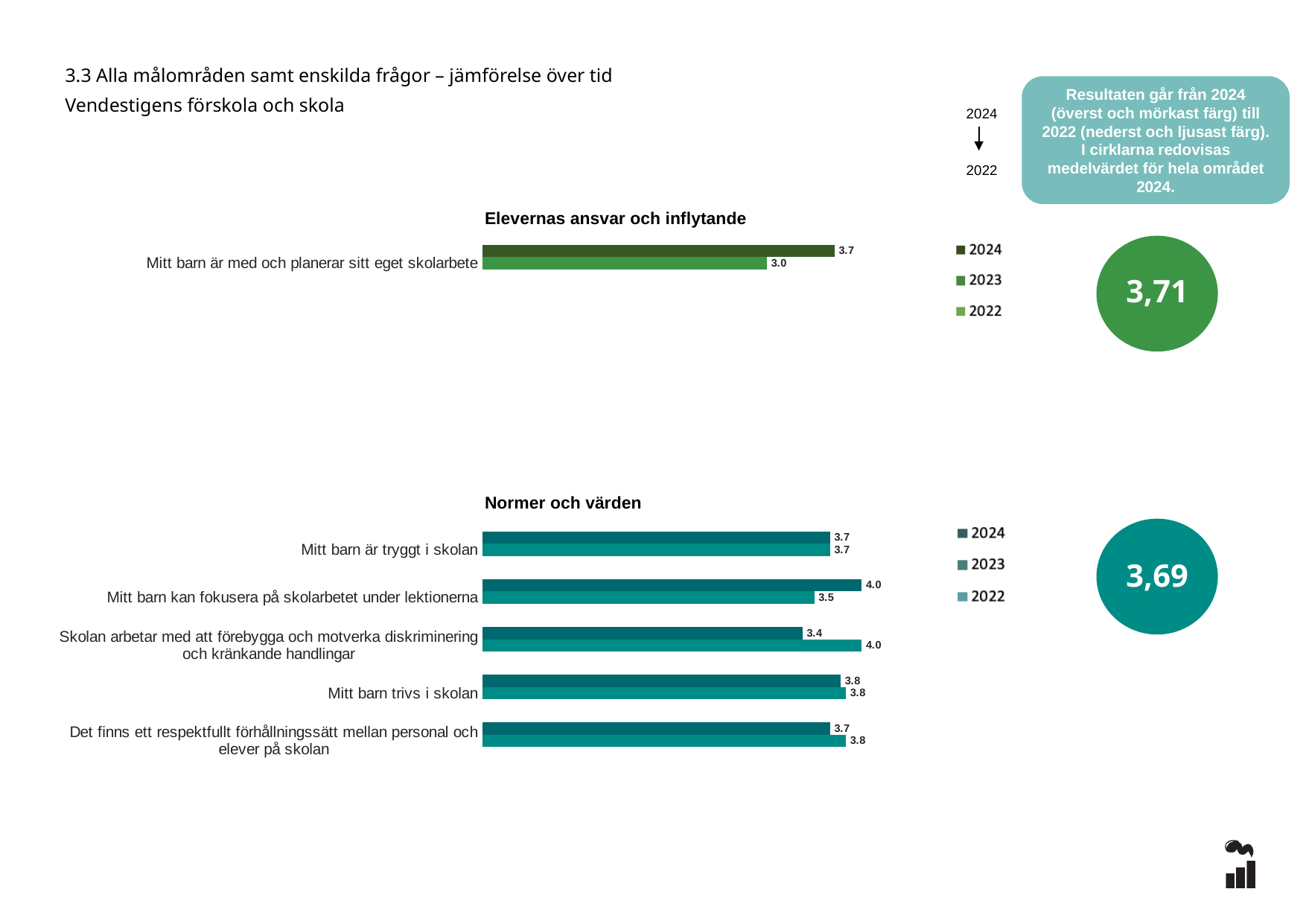
In the chart 'Normer och värden', what is the value of the lower, lighter bar for 'Skolan arbetar med att förebygga och motverka diskriminering och kränkande handlingar'? 4.0 In the chart 'Elevernas ansvar och inflytande', what is the difference between the two bars for 'Mitt barn är med och planerar sitt eget skolarbete'? 0.7 In the chart 'Normer och värden', which category has the lowest 2024 (top bar) value? Skolan arbetar med att förebygga och motverka diskriminering och kränkande handlingar In the chart 'Normer och värden', which category has the highest 2024 (top bar) value? Mitt barn kan fokusera på skolarbetet under lektionerna What value is shown in the circle next to the chart 'Normer och värden'? 3,69 In the chart 'Normer och värden', what is the 2024 (top, darkest bar) value for 'Mitt barn kan fokusera på skolarbetet under lektionerna'? 4.0 How many series does the legend of the chart 'Normer och värden' list? 3 What kind of chart is 'Normer och värden'? Bar chart In the chart 'Elevernas ansvar och inflytande', what is the value of the lower, lighter bar for 'Mitt barn är med och planerar sitt eget skolarbete'? 3.0 In the chart 'Elevernas ansvar och inflytande', what is the 2024 (top, darkest bar) value for 'Mitt barn är med och planerar sitt eget skolarbete'? 3.7 In the chart 'Normer och värden', what is the difference between the top bar and the lower bar for 'Mitt barn kan fokusera på skolarbetet under lektionerna'? 0.5 How many categories (questions) are plotted in the chart 'Normer och värden'? 5